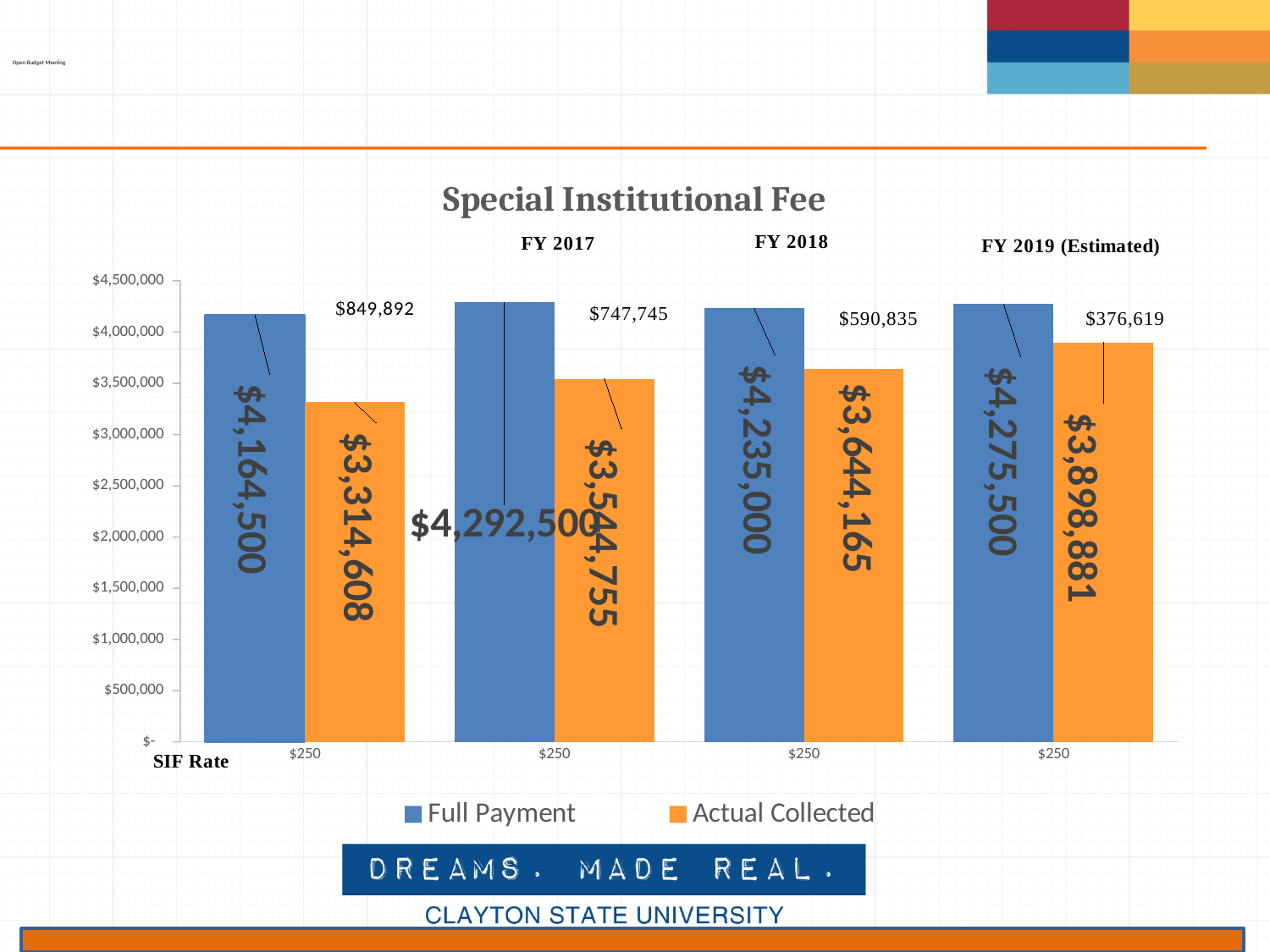
What is the Actual Collected value for FY 2019 (Estimated)? $3,898,881 What is the Full Payment value for FY 2018? $4,235,000 How many series does the legend list? 2 Do the Actual Collected values rise or fall from left to right across the chart? rise Which is larger, the Full Payment for FY 2017 or for FY 2018? FY 2017 What is the difference between Full Payment and Actual Collected for FY 2017? $747,745 Which group of bars has the lowest Actual Collected value? the leftmost group ($3,314,608) What is the title of the chart? Special Institutional Fee What kind of chart is shown on the slide? bar chart Which group of bars has the highest Actual Collected value? FY 2019 (Estimated) How many groups of bars are shown in the chart? 4 What is the Full Payment value for the leftmost group of bars? $4,164,500